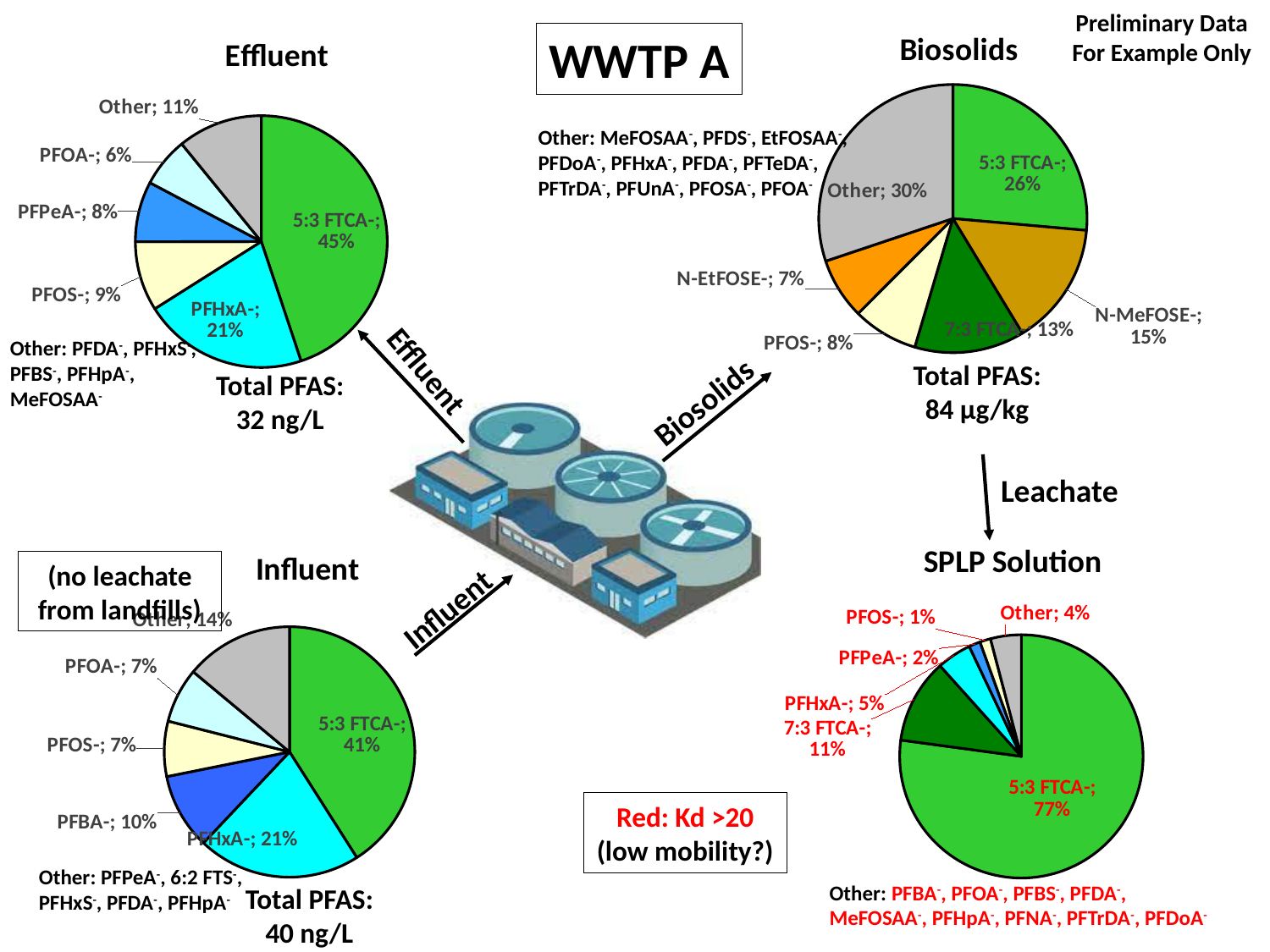
In the SPLP Solution pie chart, which is larger, 7:3 FTCA- or PFHxA-? 7:3 FTCA- In the SPLP Solution pie chart, what share does 5:3 FTCA- have? 77% In the Effluent pie chart, what share does 5:3 FTCA- have? 45% What Total PFAS value is shown below the Biosolids pie chart? 84 µg/kg In the Biosolids pie chart, which labelled slice is the largest? Other In the Effluent pie chart, what is the percentage for PFHxA-? 21% In the Influent pie chart, what is the percentage for PFBA-? 10% In the Biosolids pie chart, which slice is the smallest? N-EtFOSE- In the Influent pie chart, what is the difference between the 5:3 FTCA- share and the PFHxA- share? 20% How many slices does the SPLP Solution pie chart have? 6 What type of chart is used for the Effluent data? Pie chart In the Biosolids pie chart, what is the percentage for N-MeFOSE-? 15%